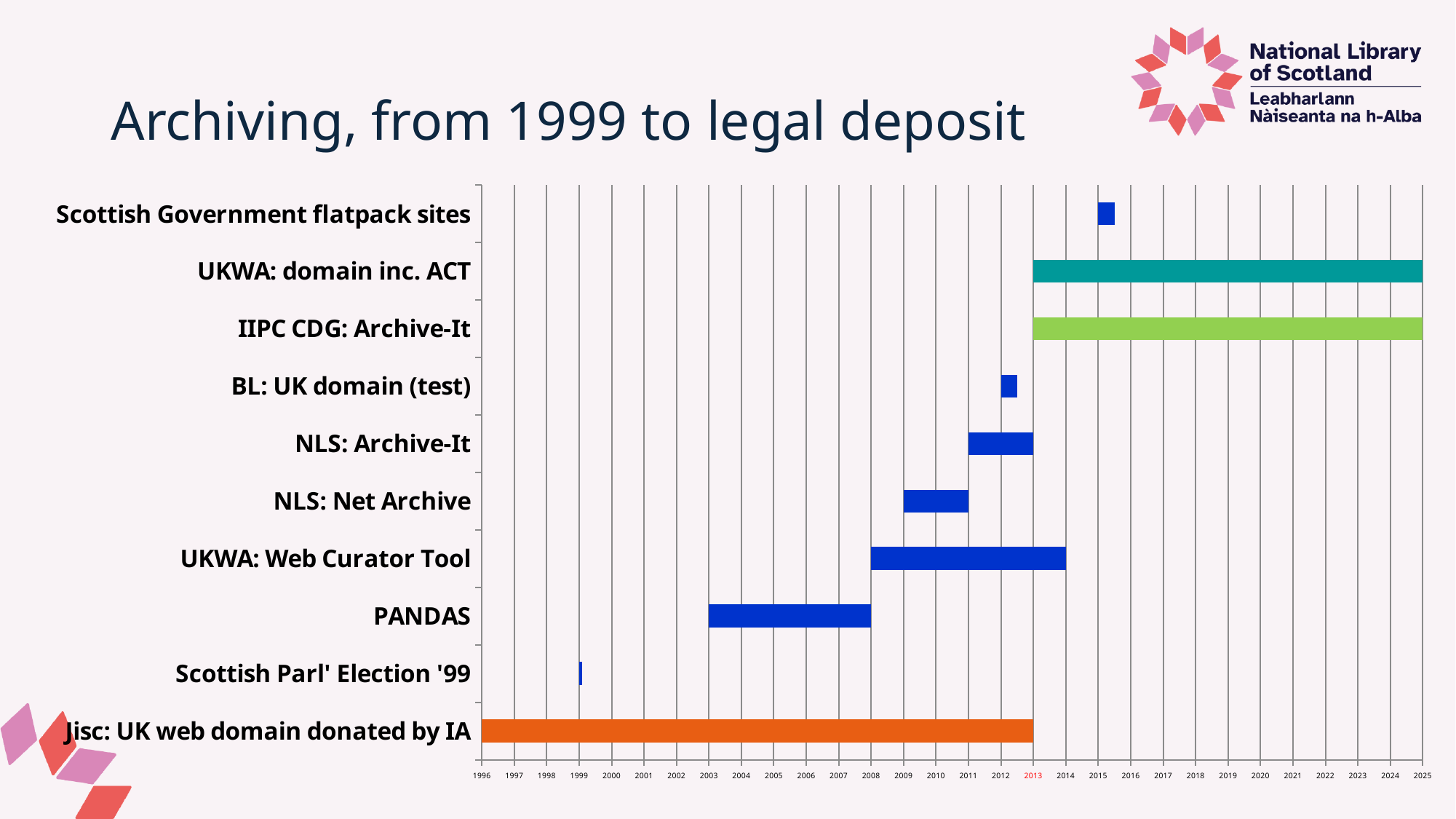
In which year does the bar for 'NLS: Net Archive' begin? 2009 How many categories are listed on the vertical axis of the chart? 10 In which year does the bar for 'Jisc: UK web domain donated by IA' end? 2013 In which year does the PANDAS bar begin? 2003 In which year do the bars for 'UKWA: domain inc. ACT' and 'IIPC CDG: Archive-It' begin? 2013 In which year does the bar for 'Jisc: UK web domain donated by IA' begin? 1996 In which year does the bar for 'UKWA: Web Curator Tool' end? 2014 Which year label on the x axis is shown in red? 2013 What kind of chart is shown on the slide? Bar chart Which category has the longest bar on the chart? Jisc: UK web domain donated by IA Which category has the shortest bar on the chart? Scottish Parl' Election '99 Which bar spans more years, PANDAS or NLS: Net Archive? PANDAS